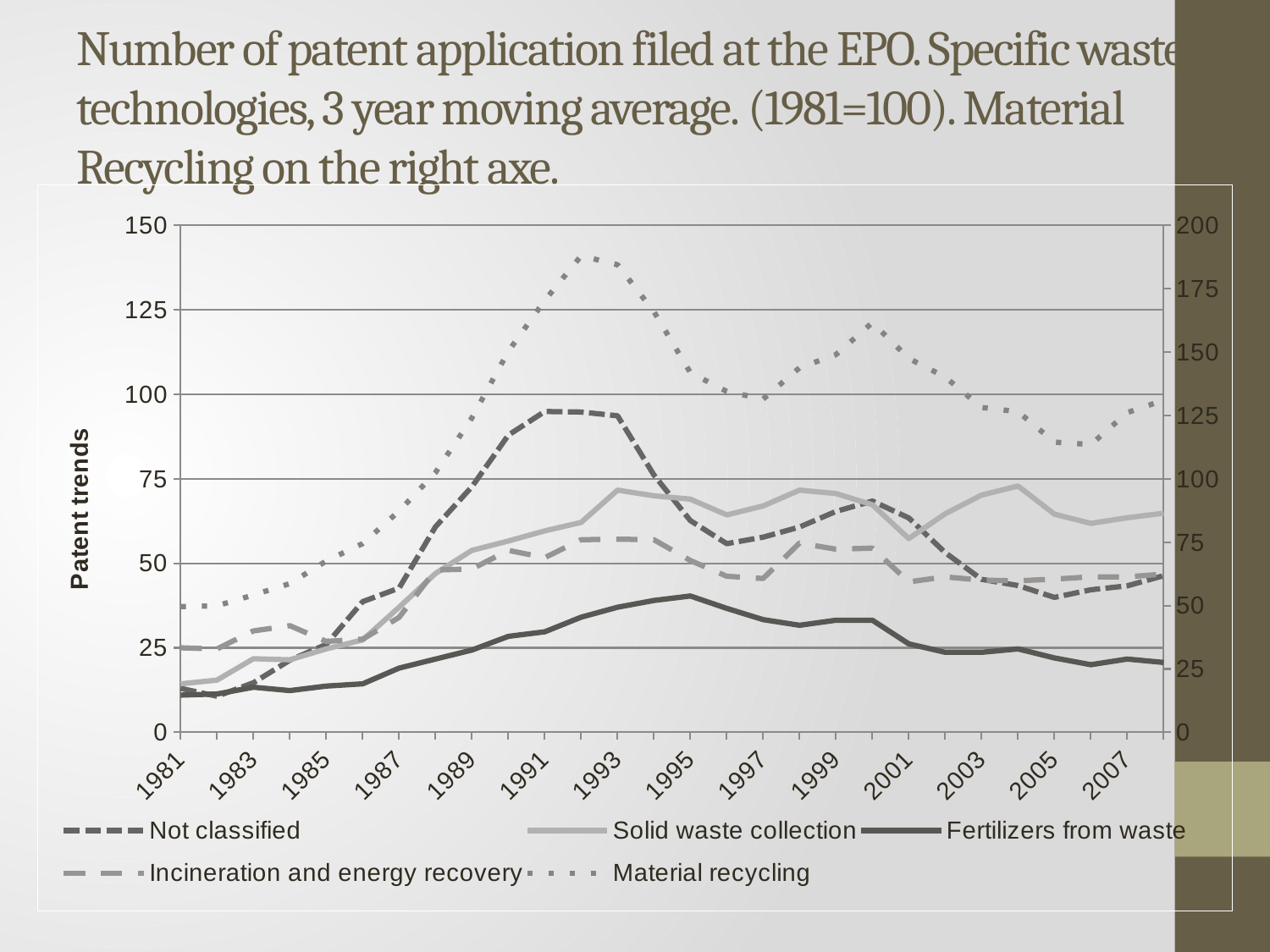
Which series has the highest value on the left axis in 1993? Not classified Is the value for Solid waste collection in 2004 greater or less than 50? greater Is the value for Fertilizers from waste in 1995 greater or less than 50? less Is the value for Not classified in 1991 greater or less than 75? greater Which series has the lowest value in 1993? Fertilizers from waste What is the title of the vertical axis on the left? Patent trends How many year labels are shown on the x axis? 14 What kind of chart is shown on the slide? line chart In 2005, which is larger: Solid waste collection or Not classified? Solid waste collection Which series is plotted on the right axis according to the title? Material recycling How many series does the legend list? 5